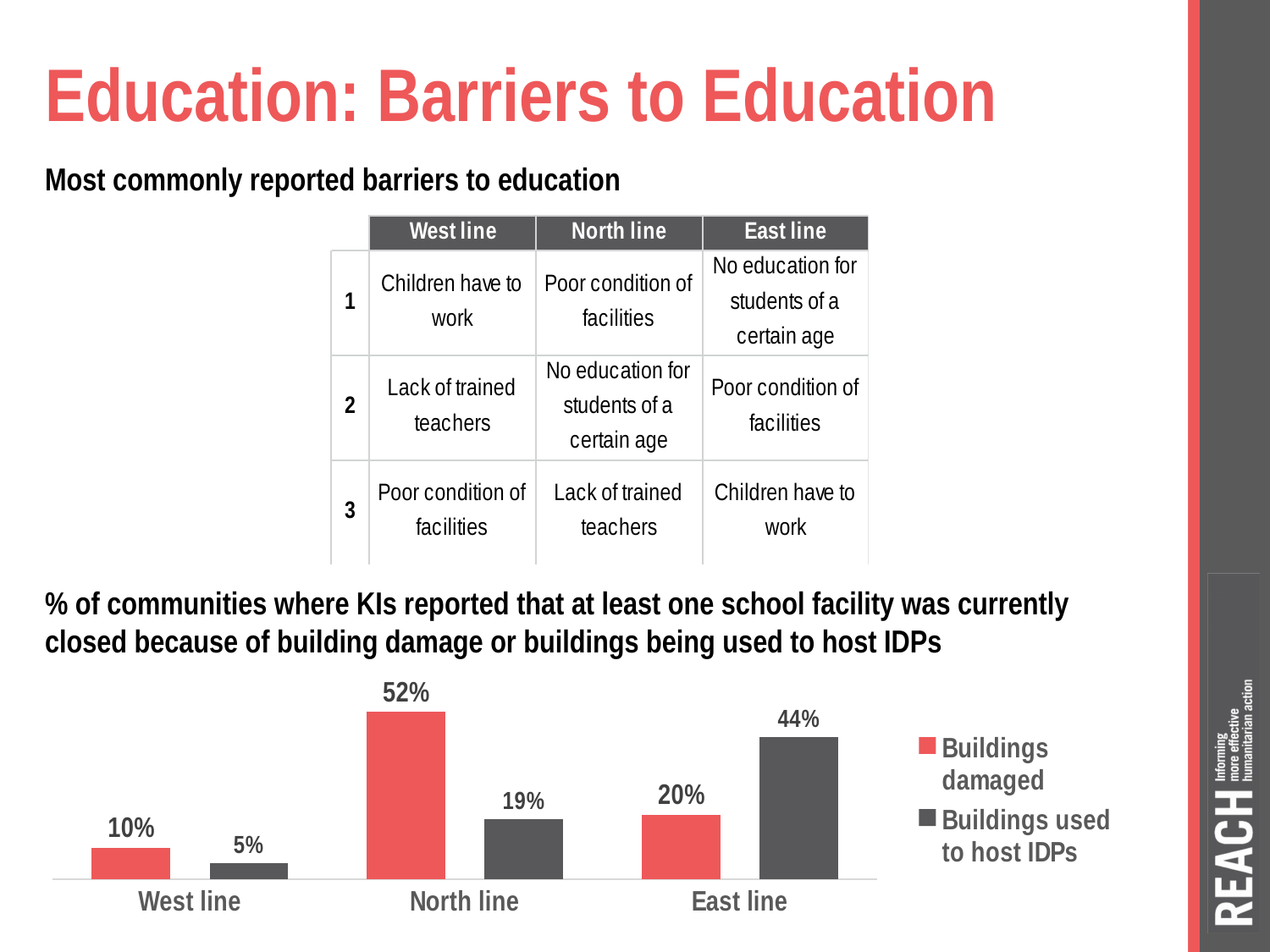
What colour represents Buildings damaged in the chart? Red What is the value for Buildings used to host IDPs in East line? 44% What kind of chart is shown on the slide? Bar chart Which is larger in East line: Buildings damaged or Buildings used to host IDPs? Buildings used to host IDPs What is the value for Buildings damaged in North line? 52% How many series does the chart legend list? 2 What is the difference between Buildings damaged and Buildings used to host IDPs in North line? 33% What is the value for Buildings used to host IDPs in West line? 5% What is the value for Buildings damaged in East line? 20% Which line has the highest value for Buildings damaged? North line How many lines (categories) are shown on the x axis of the chart? 3 Which line has the lowest value for Buildings used to host IDPs? West line